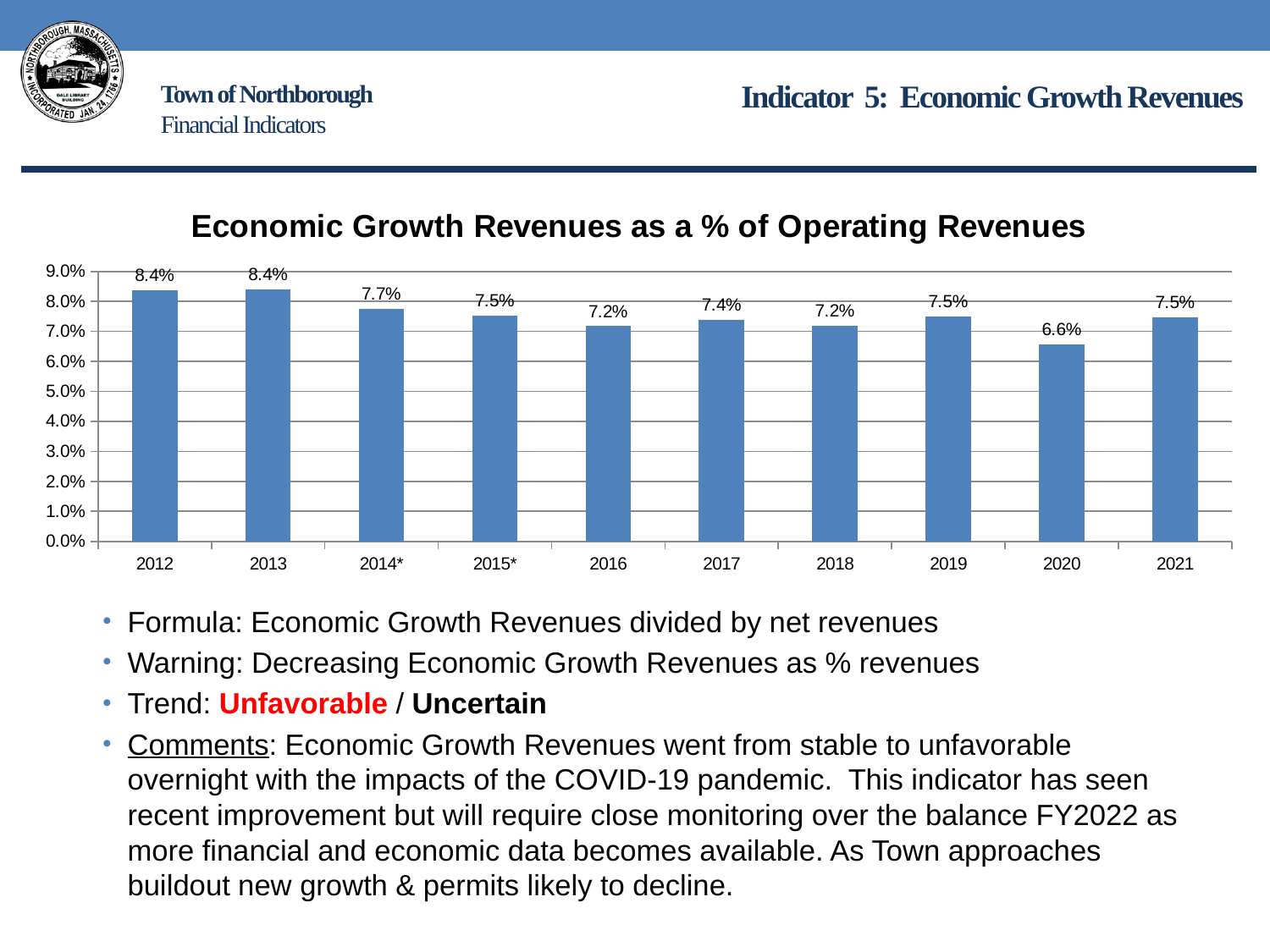
What is the value for 2014* in the chart? 7.7% Which is larger, the value for 2017 or the value for 2020? 2017 How many years are shown on the x axis of the chart? 10 Which year has the lowest value in the chart? 2020 What is the value for 2020 in the chart? 6.6% What is the title of the chart? Economic Growth Revenues as a % of Operating Revenues What is the difference between the values for 2013 and 2020? 1.8% What kind of chart is shown on the slide? bar chart Do the values rise or fall from 2012 to 2016? fall Is the value for 2012 greater or less than 8.0%? greater What is the difference between the values for 2019 and 2018? 0.3% What is the value for 2016 in the Economic Growth Revenues as a % of Operating Revenues chart? 7.2%